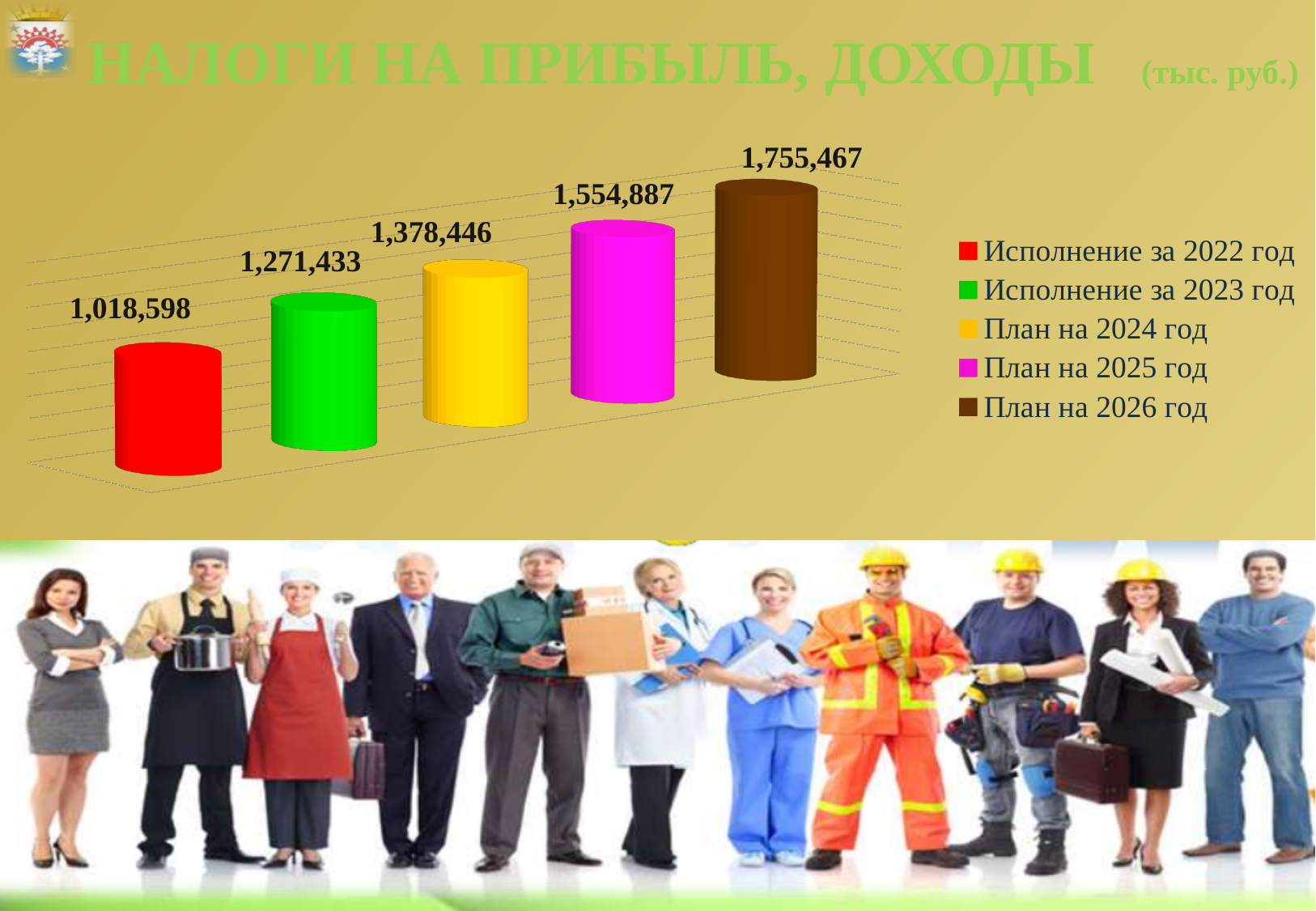
Which legend entry has the lowest value? Исполнение за 2022 год Do the values rise or fall from left to right across the bars? rise What is the difference between План на 2026 год and Исполнение за 2022 год? 736,869 How many bars are plotted on the chart? 5 Which is larger, План на 2025 год or Исполнение за 2023 год? План на 2025 год What is the value for Исполнение за 2022 год? 1,018,598 What is the value for План на 2026 год? 1,755,467 How many entries does the legend list? 5 What is the difference between План на 2025 год and План на 2024 год? 176,441 What is the value for План на 2024 год? 1,378,446 Which legend entry has the highest value? План на 2026 год What is the value for Исполнение за 2023 год? 1,271,433